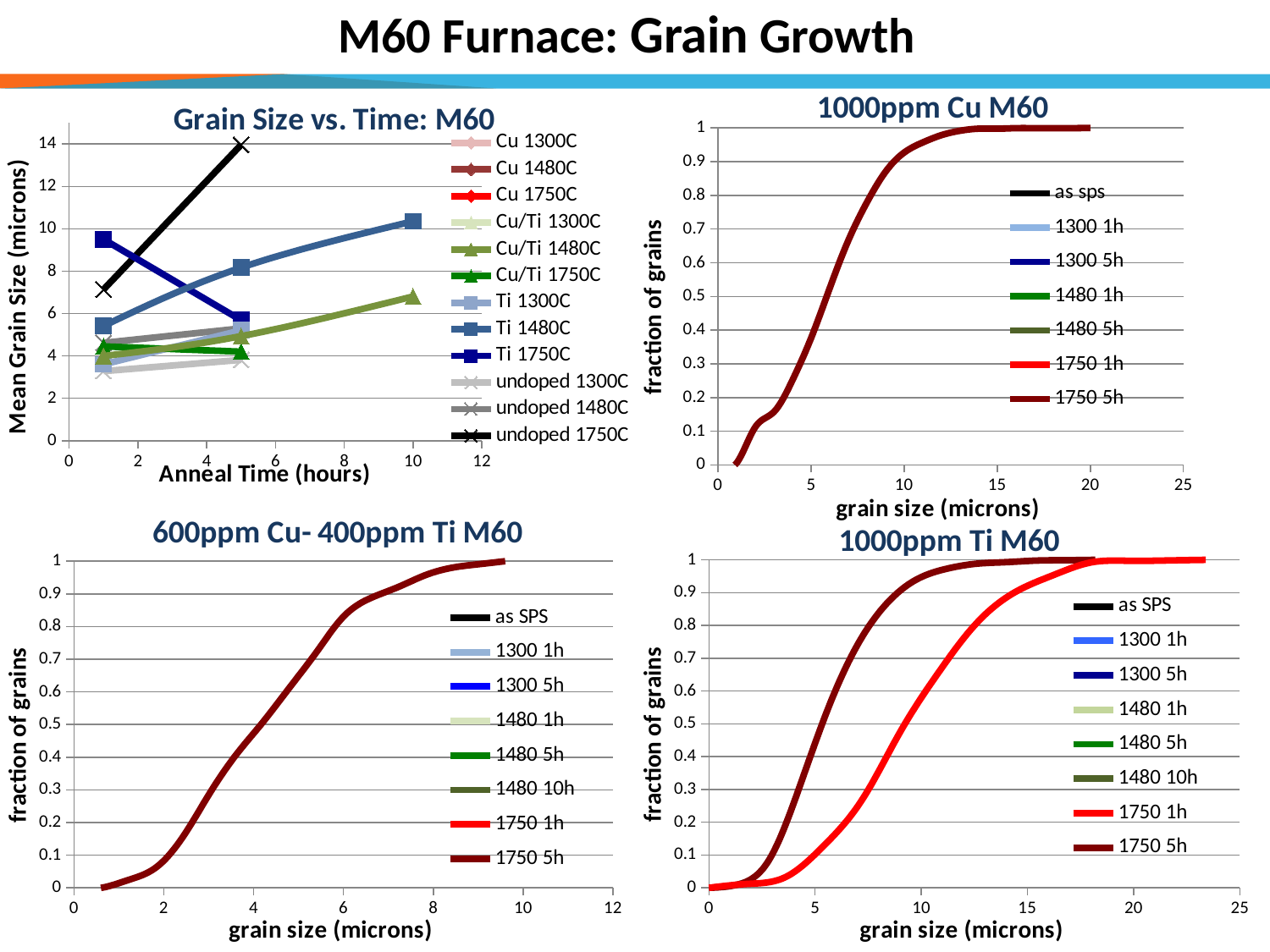
In the '600ppm Cu- 400ppm Ti M60' chart, how many series does the legend list? 8 In the 'Grain Size vs. Time: M60' chart, what is the label of the y axis? Mean Grain Size (microns) In the 'Grain Size vs. Time: M60' chart, does the mean grain size for Ti 1750C rise or fall between 1 and 5 hours of anneal time? fall In the 'Grain Size vs. Time: M60' chart, which series reaches the highest mean grain size? undoped 1750C In the 'Grain Size vs. Time: M60' chart, does the mean grain size for Ti 1480C rise or fall as anneal time increases? rise In the '1000ppm Ti M60' chart, at a grain size of 5 microns, which series has the larger fraction of grains: 1750 1h or 1750 5h? 1750 5h In the 'Grain Size vs. Time: M60' chart, is the mean grain size for undoped 1750C at 5 hours greater or less than 12 microns? greater In the '1000ppm Ti M60' chart, is the fraction of grains for 1750 5h at a grain size of 10 microns greater or less than 0.9? greater In the 'Grain Size vs. Time: M60' chart, how many series does the legend list? 12 In the 'Grain Size vs. Time: M60' chart, is the mean grain size for Ti 1750C at 1 hour greater or less than 8 microns? greater What kind of chart is the '1000ppm Cu M60' chart? line chart In the '1000ppm Cu M60' chart, how many series does the legend list? 7